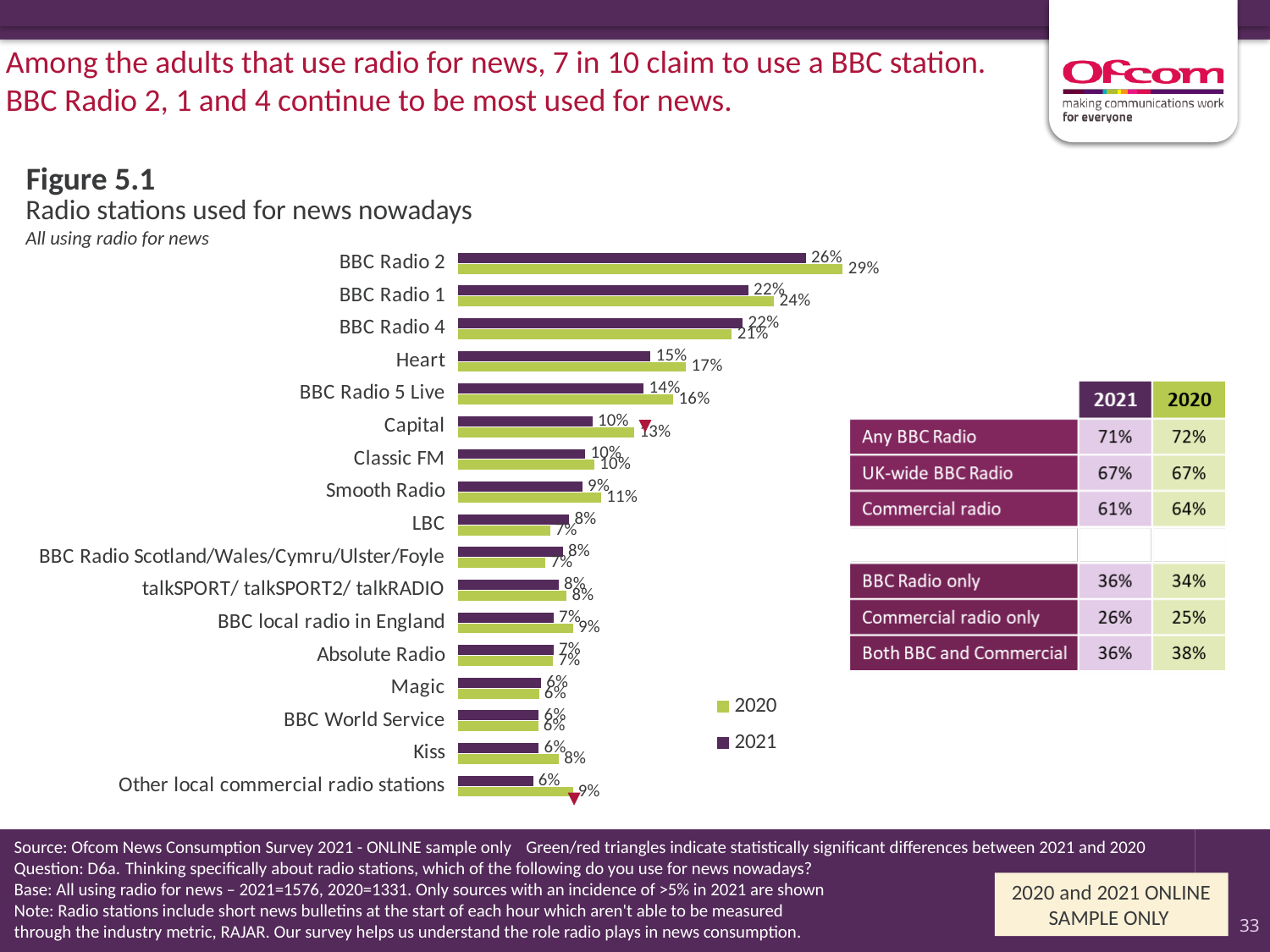
What is the 2021 value for BBC Radio 2 in the radio stations chart? 26% What is the 2021 value for BBC Radio 5 Live in the radio stations chart? 14% Which radio station has the highest 2021 value in the chart? BBC Radio 2 How many radio stations are listed as categories in the chart? 17 What is the 2020 value for BBC Radio 2 in the radio stations chart? 29% What type of chart is used to show radio stations used for news nowadays? Bar chart What is the 2020 value for Heart in the radio stations chart? 17% Which colour represents the 2021 series in the radio stations chart? Purple How many series does the legend of the radio stations chart list? 2 In the radio stations chart, is the 2021 value for BBC Radio 1 or the 2021 value for Heart larger? BBC Radio 1 What is the 2020 value for Other local commercial radio stations in the chart? 9% What is the difference between the 2020 and 2021 values for Capital in the radio stations chart? 3%